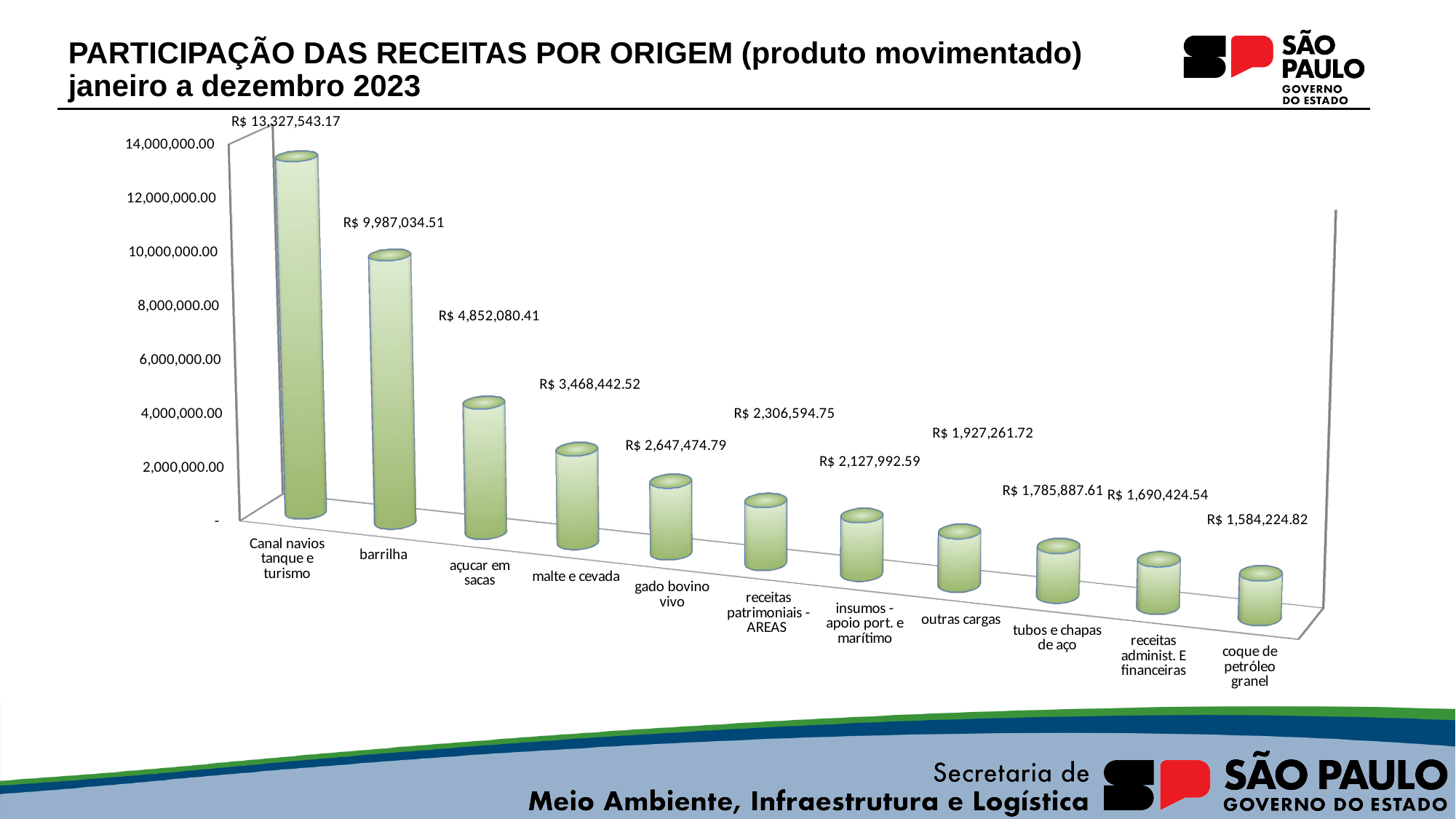
How many categories are shown in the chart? 11 What kind of chart is this? bar chart Which category has the highest value? Canal navios tanque e turismo What is the difference between Canal navios tanque e turismo and barrilha? R$ 3,340,508.66 What is the value for gado bovino vivo? R$ 2,647,474.79 Do the values rise or fall from left to right along the x axis? fall What is the difference between açucar em sacas and malte e cevada? R$ 1,383,637.89 What is the value for coque de petróleo granel? R$ 1,584,224.82 Which category has the lowest value? coque de petróleo granel What is the value for outras cargas? R$ 1,927,261.72 What is the value for barrilha? R$ 9,987,034.51 Which is larger, malte e cevada or gado bovino vivo? malte e cevada